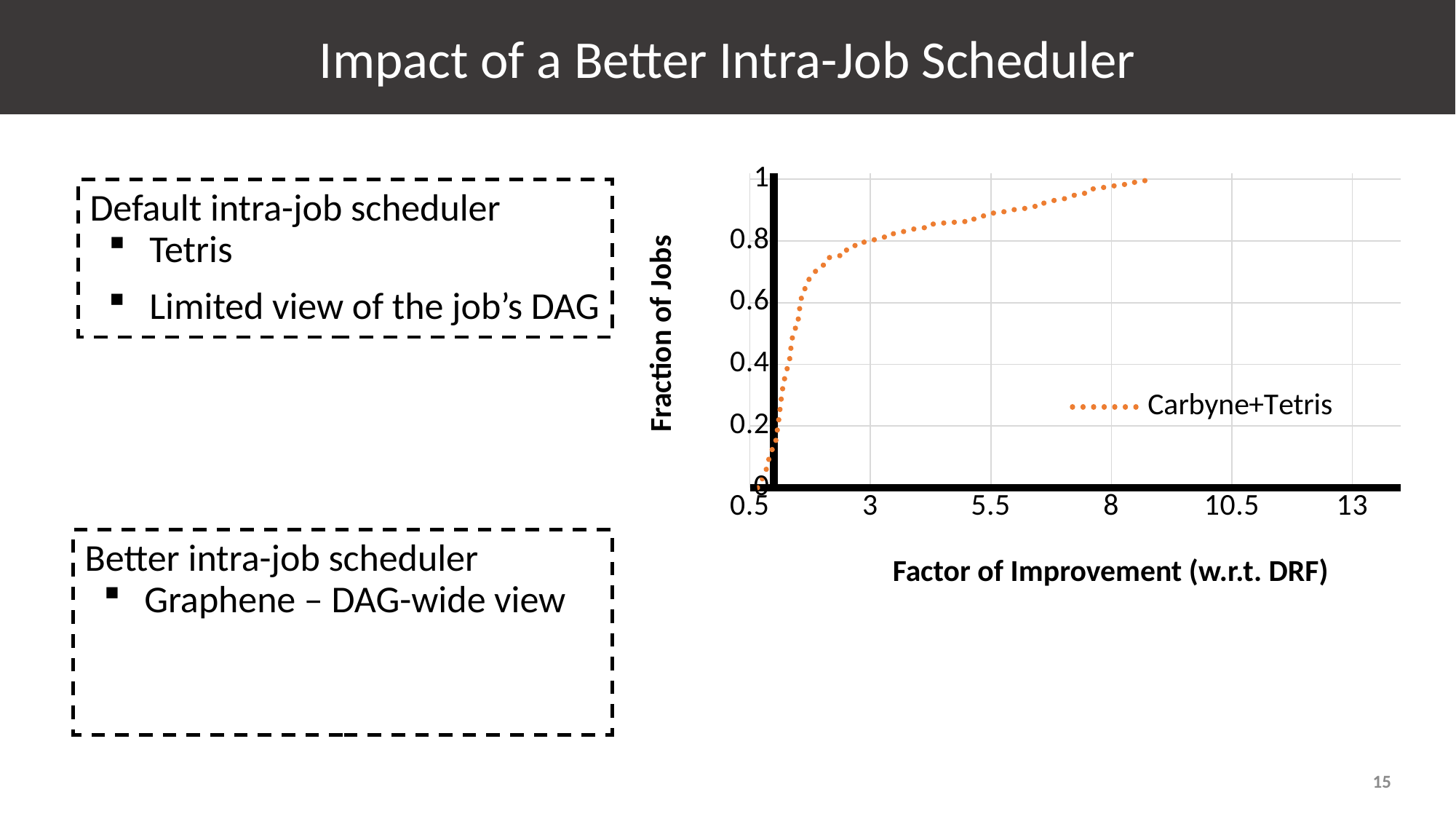
How many series does the chart's legend list? 1 Is the fraction of jobs for Carbyne+Tetris at a factor of improvement of 5.5 greater or less than 0.6? greater What is the title of the chart's x axis? Factor of Improvement (w.r.t. DRF) What kind of chart is shown on the slide? line chart Is the fraction of jobs for Carbyne+Tetris at a factor of improvement of 8 greater or less than 0.8? greater What is the highest value labelled on the chart's x axis? 13 What is the name of the series shown in the chart's legend? Carbyne+Tetris Is the fraction of jobs for Carbyne+Tetris at a factor of improvement of 3 greater or less than 0.4? greater Does the Carbyne+Tetris curve rise or fall as the factor of improvement increases along the x axis? rise